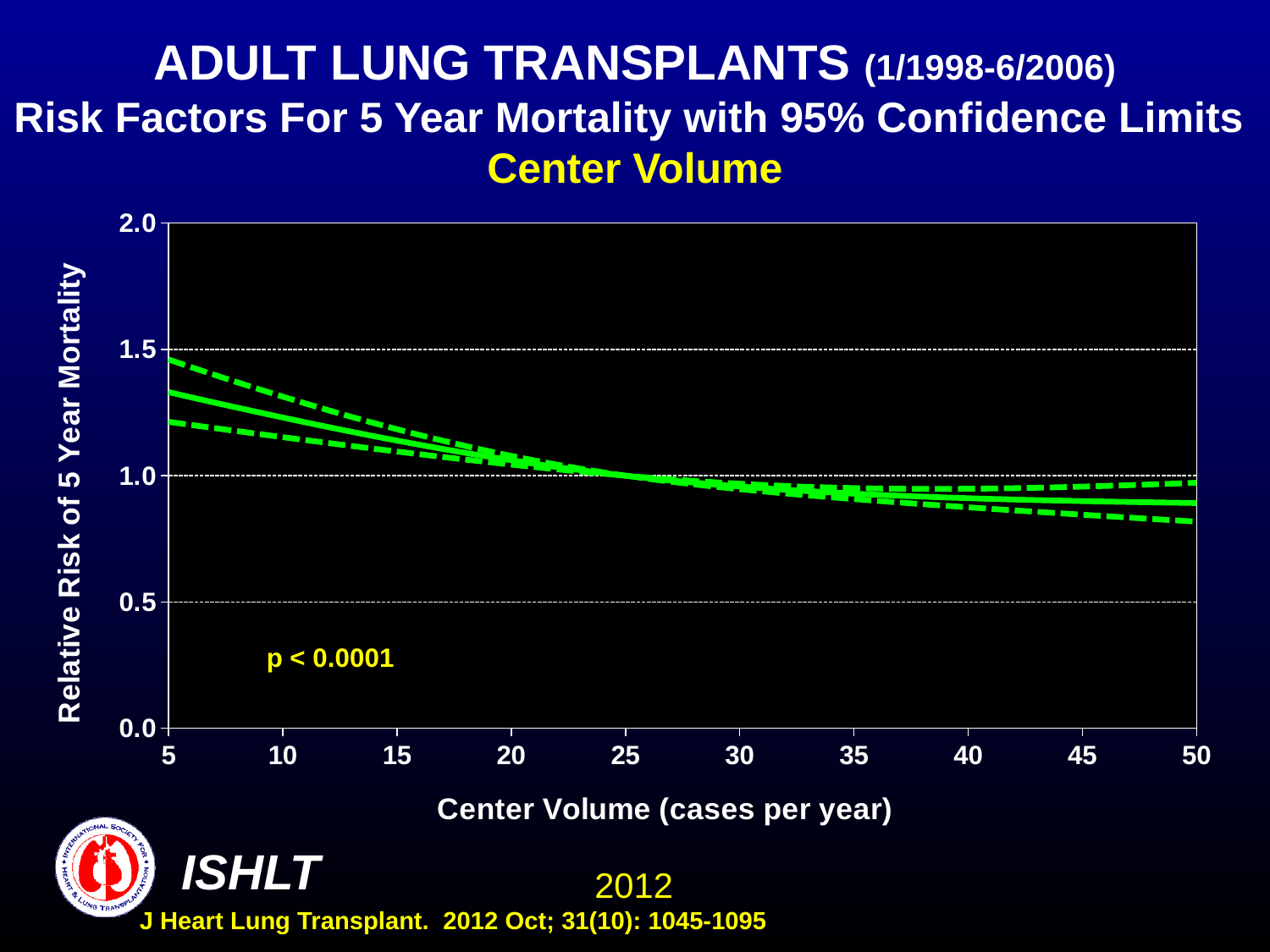
How many lines are plotted on the chart? 3 Is the relative risk (solid line) at a center volume of 50 cases per year greater or less than 1.0? less Does the relative risk of 5 year mortality rise or fall as center volume increases along the x axis? fall What kind of chart is shown on the slide? line chart What p-value is printed on the chart? p < 0.0001 Is the relative risk at a center volume of 5 cases per year larger or smaller than at 50 cases per year? larger Is the lower 95% confidence limit at a center volume of 50 cases per year greater or less than 0.5? greater Is the upper 95% confidence limit at a center volume of 5 cases per year greater or less than 1.5? less What is the label of the x axis? Center Volume (cases per year)